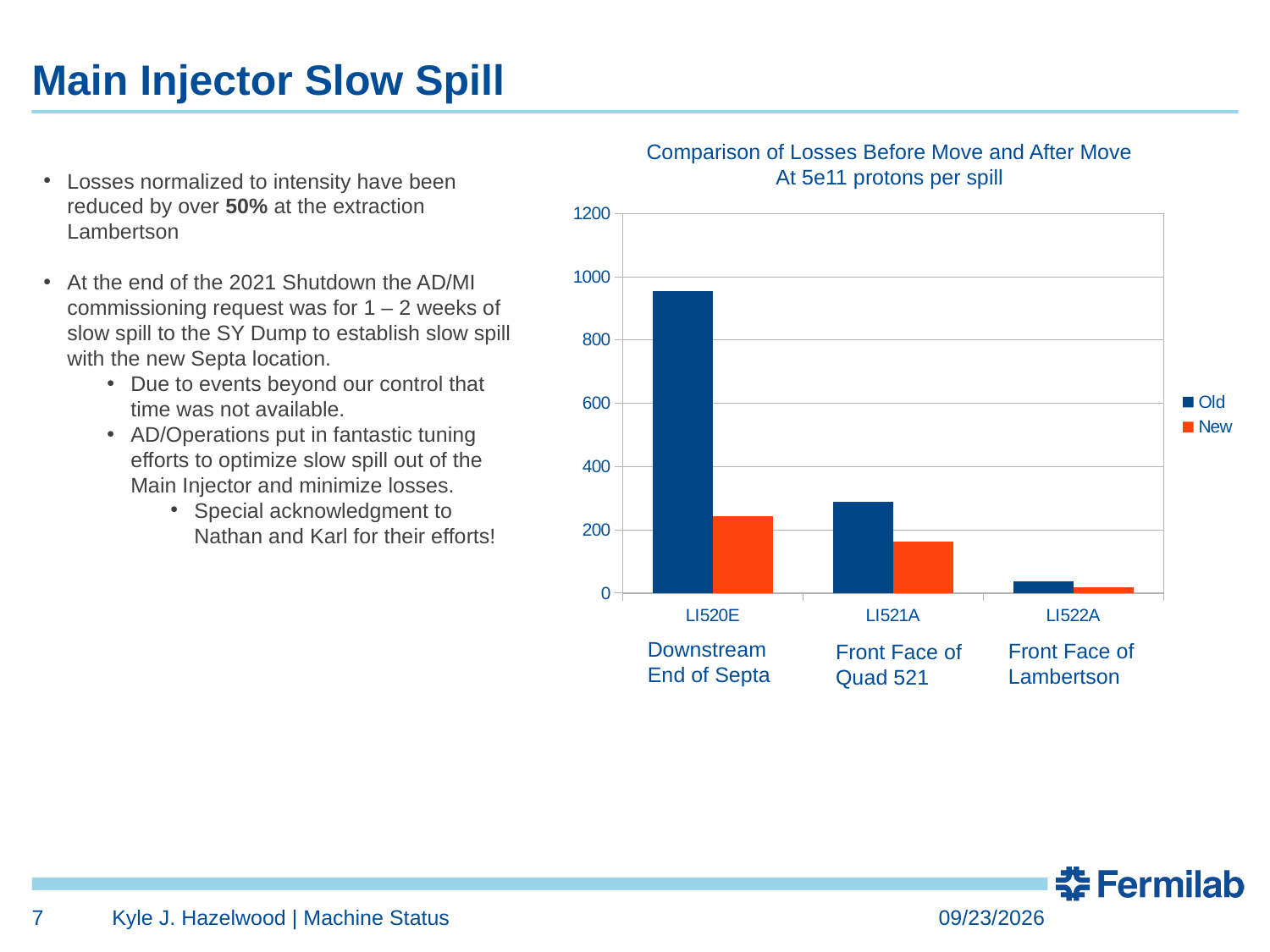
Do the Old values rise or fall from LI520E to LI522A along the x axis? fall Is the Old value for LI520E greater or less than 800? greater Which category has the lowest Old value? LI522A Which category has the highest Old value? LI520E Is the New value for LI520E greater or less than 400? less What kind of chart is shown on the slide? bar chart How many series does the legend list? 2 Which series is shown in orange in the legend? New Is the Old value for LI521A greater or less than 200? greater How many categories are shown on the x axis? 3 Which category has the lowest New value? LI522A Which is larger for LI521A, the Old value or the New value? Old